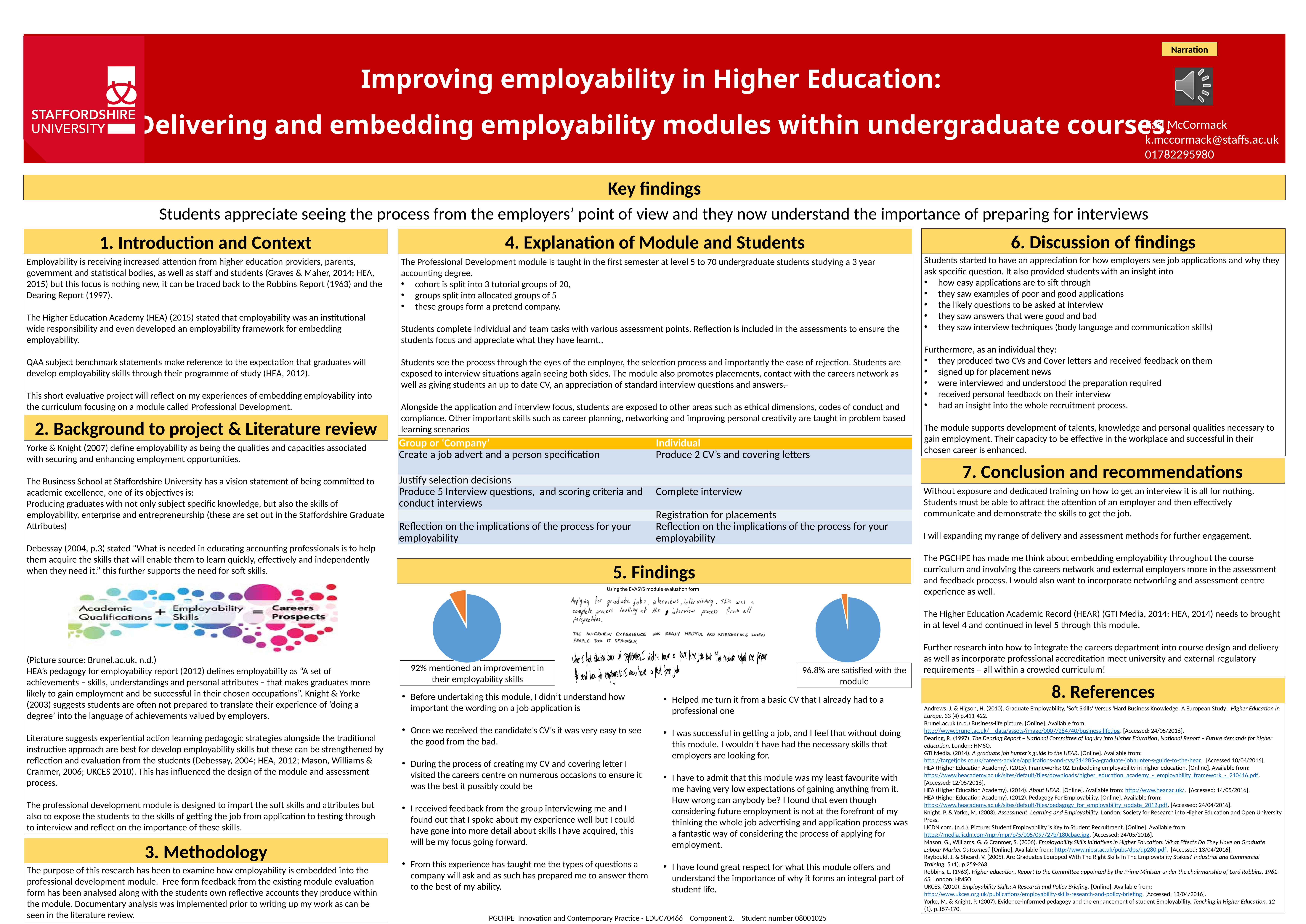
How many pie charts are shown in the '5. Findings' section? 2 What is the difference between the 96.8% satisfied with the module (right pie chart) and the 92% mentioning an improvement in employability skills (left pie chart)? 4.8% In the right pie chart in the Findings section, which slice is smaller, the blue one or the orange one? Orange How many slices does the right pie chart in the Findings section have? 2 According to the caption above the pie charts, which evaluation form was used for the Findings data? EVASYS module evaluation form Which is larger: the share satisfied with the module (right pie chart) or the share mentioning an improvement in employability skills (left pie chart)? Share satisfied with the module (96.8%) In the left pie chart in the Findings section, which slice is larger, the blue one or the orange one? Blue In the left pie chart in the Findings section, what share of students mentioned an improvement in their employability skills? 92% Is the share shown by the blue slice in the left pie chart in the Findings section greater or less than 50%? greater What kind of charts are shown in the '5. Findings' section? Pie charts In the right pie chart in the Findings section, what share of students are satisfied with the module? 96.8% How many slices does the left pie chart in the Findings section have? 2